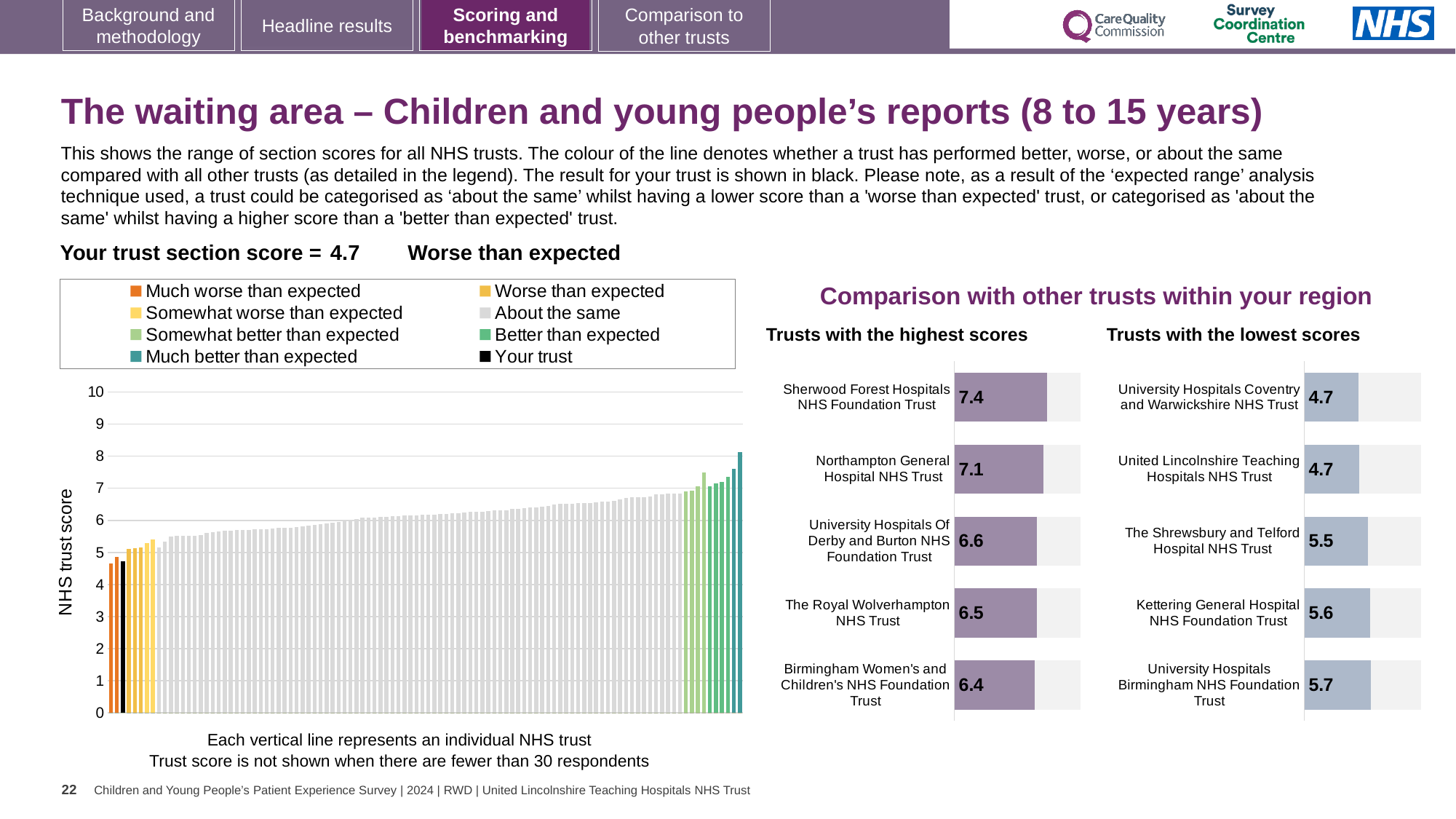
How many entries does the legend of the main chart on the left list? 8 On the 'Trusts with the highest scores' chart, what is the difference between the scores of Sherwood Forest Hospitals NHS Foundation Trust and Northampton General Hospital NHS Trust? 0.3 On the 'Trusts with the highest scores' chart, what is the score for Sherwood Forest Hospitals NHS Foundation Trust? 7.4 On the 'Trusts with the highest scores' chart, what is the score for The Royal Wolverhampton NHS Trust? 6.5 On the 'Trusts with the lowest scores' chart, which has the larger score: The Shrewsbury and Telford Hospital NHS Trust or Kettering General Hospital NHS Foundation Trust? Kettering General Hospital NHS Foundation Trust On the 'Trusts with the lowest scores' chart, what is the score for Kettering General Hospital NHS Foundation Trust? 5.6 On the 'Trusts with the highest scores' chart, which trust has the lowest score? Birmingham Women's and Children's NHS Foundation Trust On the main chart on the left, is the value for the black bar (your trust) greater or less than 5? less What is the y-axis label of the main chart on the left? NHS trust score What type of chart is the main chart on the left showing all NHS trusts? bar chart On the 'Trusts with the lowest scores' chart, which trust has the highest score? University Hospitals Birmingham NHS Foundation Trust On the 'Trusts with the lowest scores' chart, how many trusts are shown? 5